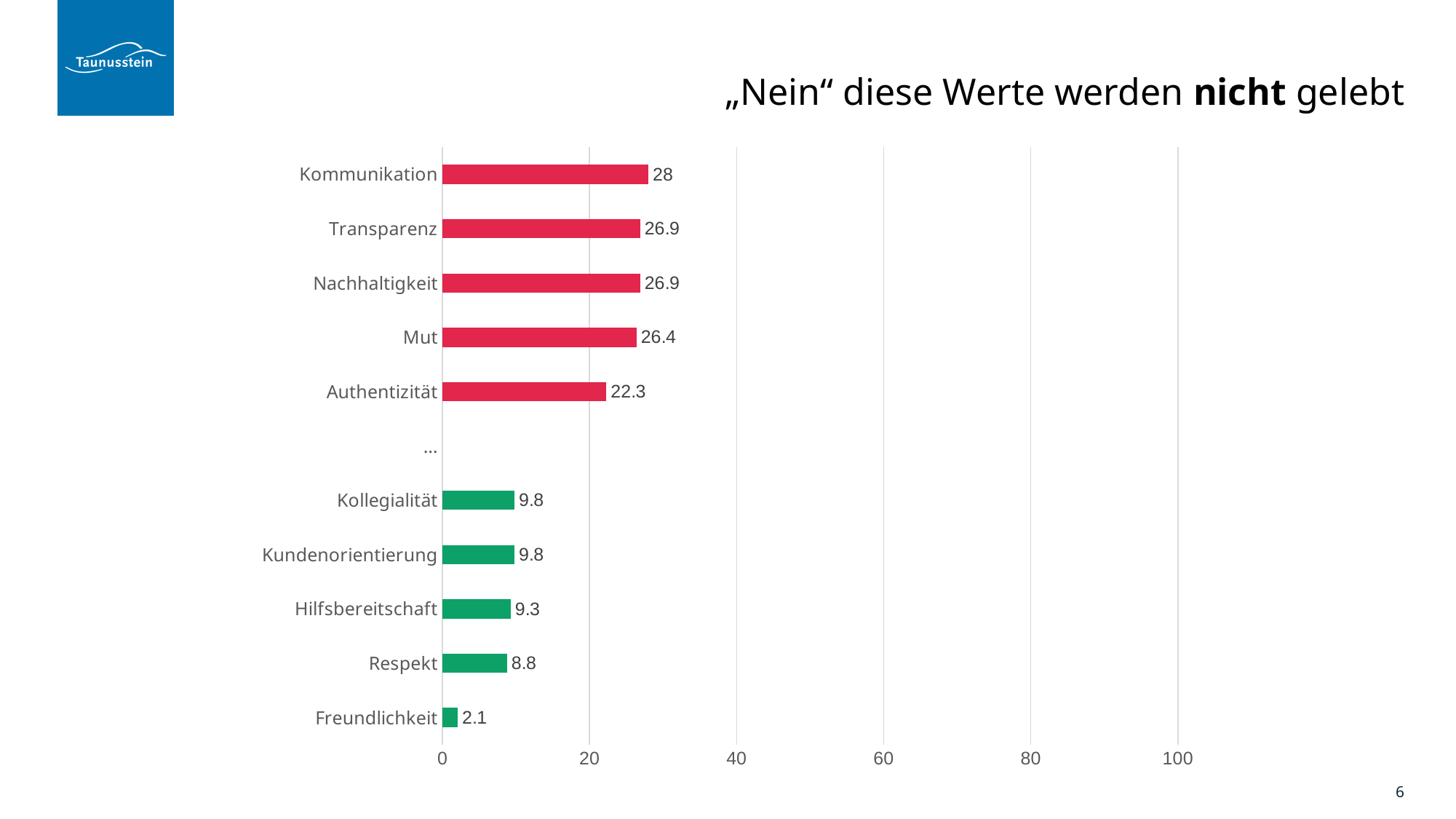
What colour are the bars for the five categories with the highest values? red Which is larger, the value for Transparenz or the value for Authentizität? Transparenz Which category has the highest value? Kommunikation What is the value for Mut? 26.4 What is the value for Authentizität? 22.3 What is the difference between the values for Mut and Hilfsbereitschaft? 17.1 Which category has the lowest value? Freundlichkeit What is the difference between the values for Kommunikation and Freundlichkeit? 25.9 What is the value for Kommunikation? 28 Is the value for Kollegialität greater or less than 20? less What is the value for Respekt? 8.8 What kind of chart is shown on the slide? bar chart